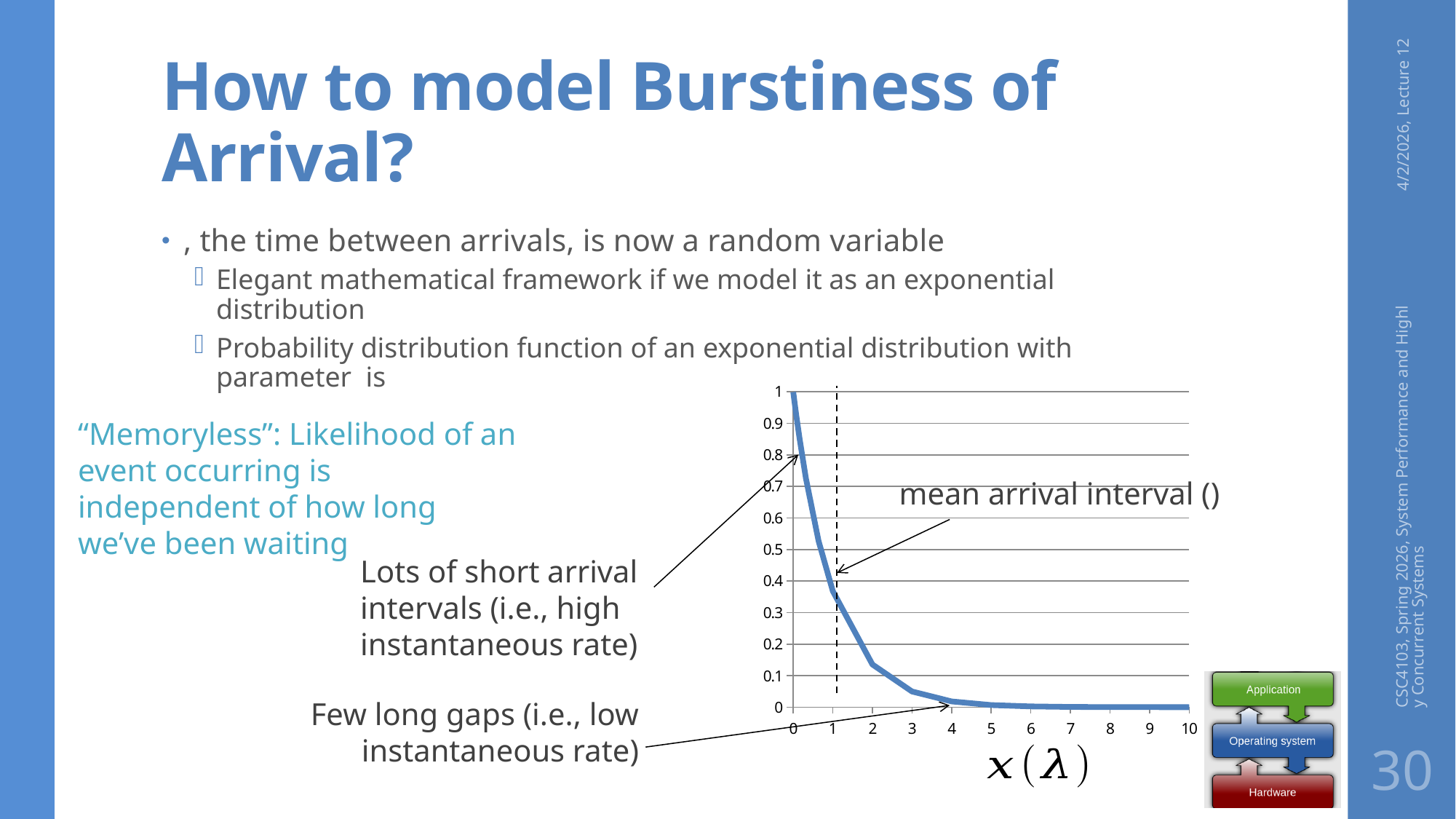
What kind of chart is shown on the slide? line chart Is the value of the curve at x = 3 greater or less than 0.1? less At which x value is the curve at its highest? 0 What is the largest value labelled on the x axis? 10 Do the values of the curve rise or fall as x increases? fall Is the value of the curve at x = 2 greater or less than 0.2? less Is the value of the curve at x = 1 greater or less than 0.2? greater Which is larger, the value of the curve at x = 1 or at x = 5? x = 1 How many tick labels are shown on the x axis? 11 What does the dashed vertical line on the chart mark? mean arrival interval